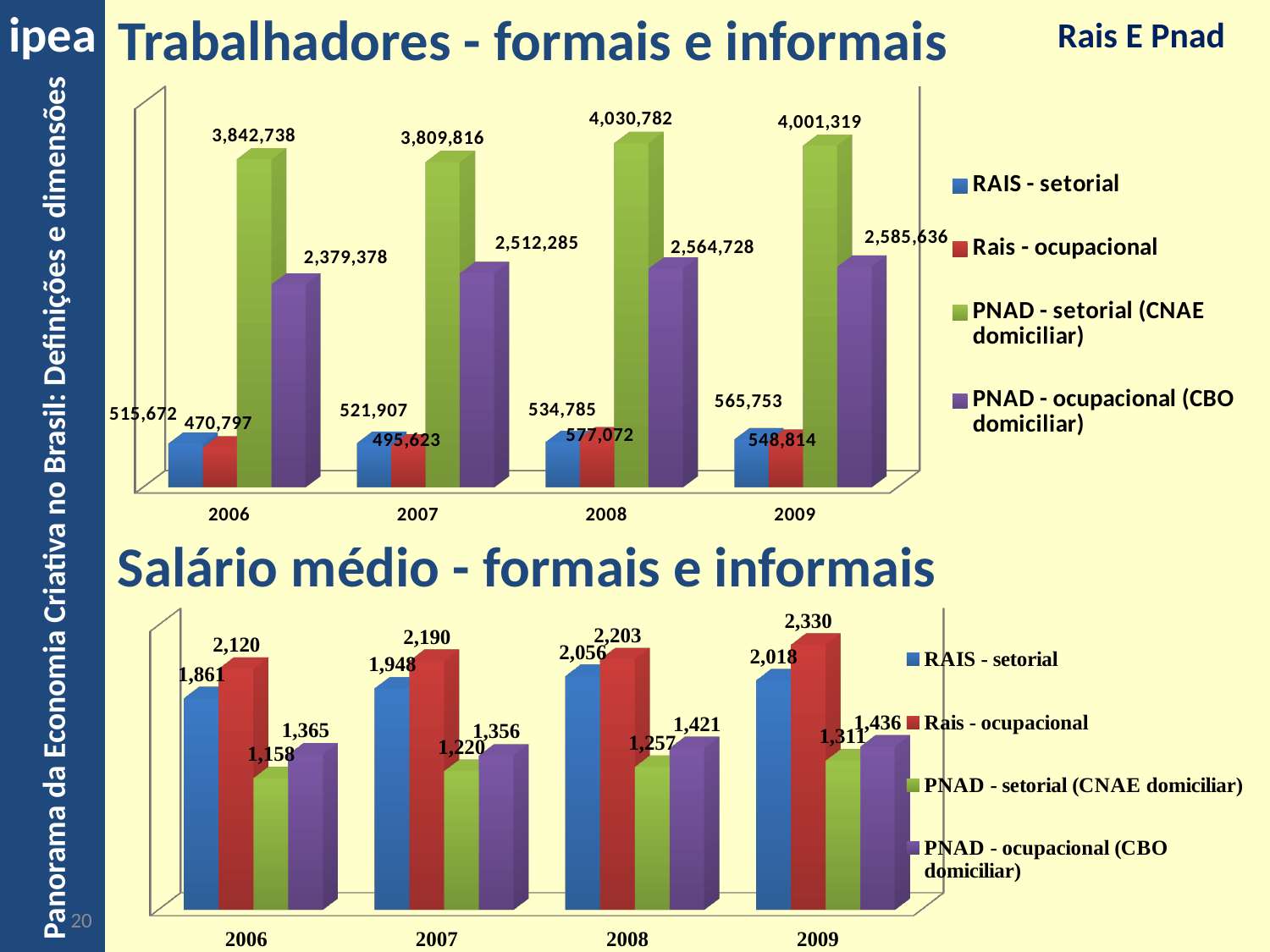
In the 'Salário médio - formais e informais' chart, what is the difference between the Rais - ocupacional value and the RAIS - setorial value in 2006? 259 In the 'Trabalhadores - formais e informais' chart, what is the difference between the PNAD - setorial (CNAE domiciliar) value and the PNAD - ocupacional (CBO domiciliar) value in 2006? 1,463,360 What kind of chart is 'Salário médio - formais e informais'? bar chart In the 'Salário médio - formais e informais' chart, which is larger in 2008: RAIS - setorial or Rais - ocupacional? Rais - ocupacional In the 'Trabalhadores - formais e informais' chart, what is the value for PNAD - setorial (CNAE domiciliar) in 2008? 4,030,782 In the 'Trabalhadores - formais e informais' chart, what is the value for Rais - ocupacional in 2006? 470,797 In the 'Salário médio - formais e informais' chart, what is the value for Rais - ocupacional in 2009? 2,330 How many years are shown on the x axis of the 'Salário médio - formais e informais' chart? 4 In the 'Trabalhadores - formais e informais' chart, does the RAIS - setorial value rise or fall from 2006 to 2009? rise How many series does the legend of the 'Trabalhadores - formais e informais' chart list? 4 In the 'Trabalhadores - formais e informais' chart, which year has the highest value for PNAD - ocupacional (CBO domiciliar)? 2009 In the 'Salário médio - formais e informais' chart, which series has the lowest value in 2007? PNAD - setorial (CNAE domiciliar)